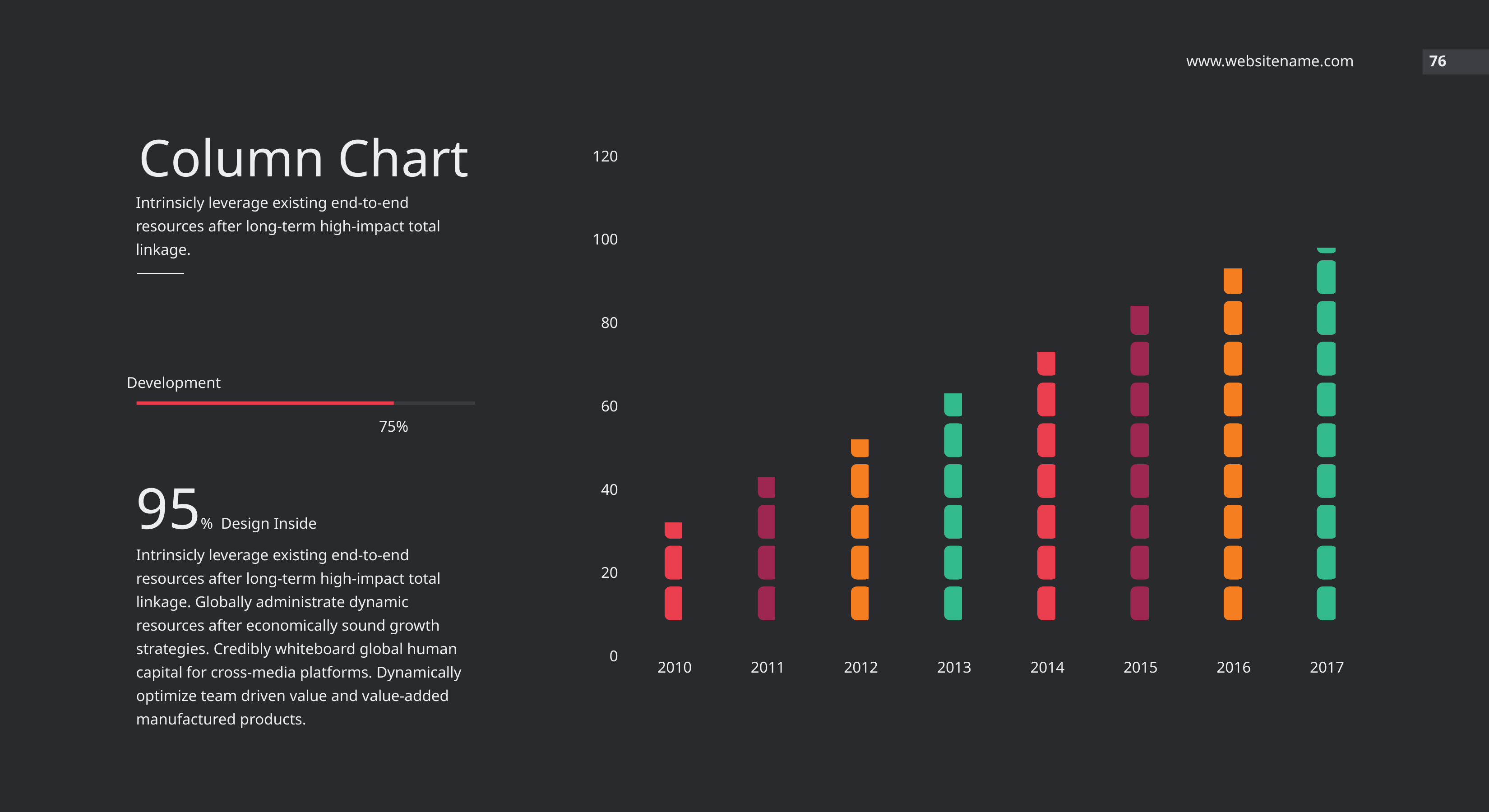
How many years are shown on the x axis of the chart? 8 What is the title shown above the chart description on the slide? Column Chart Which year has the larger value, 2016 or 2011? 2016 Which year has the larger value, 2012 or 2015? 2015 Do the bar values rise or fall from 2010 to 2017? rise Is the value for 2016 greater or less than 80? greater Is the value for 2014 greater or less than 60? greater Which year has the highest bar in the chart? 2017 Is the value for 2010 greater or less than 40? less What kind of chart is shown on the slide? bar chart Which year has the lowest bar in the chart? 2010